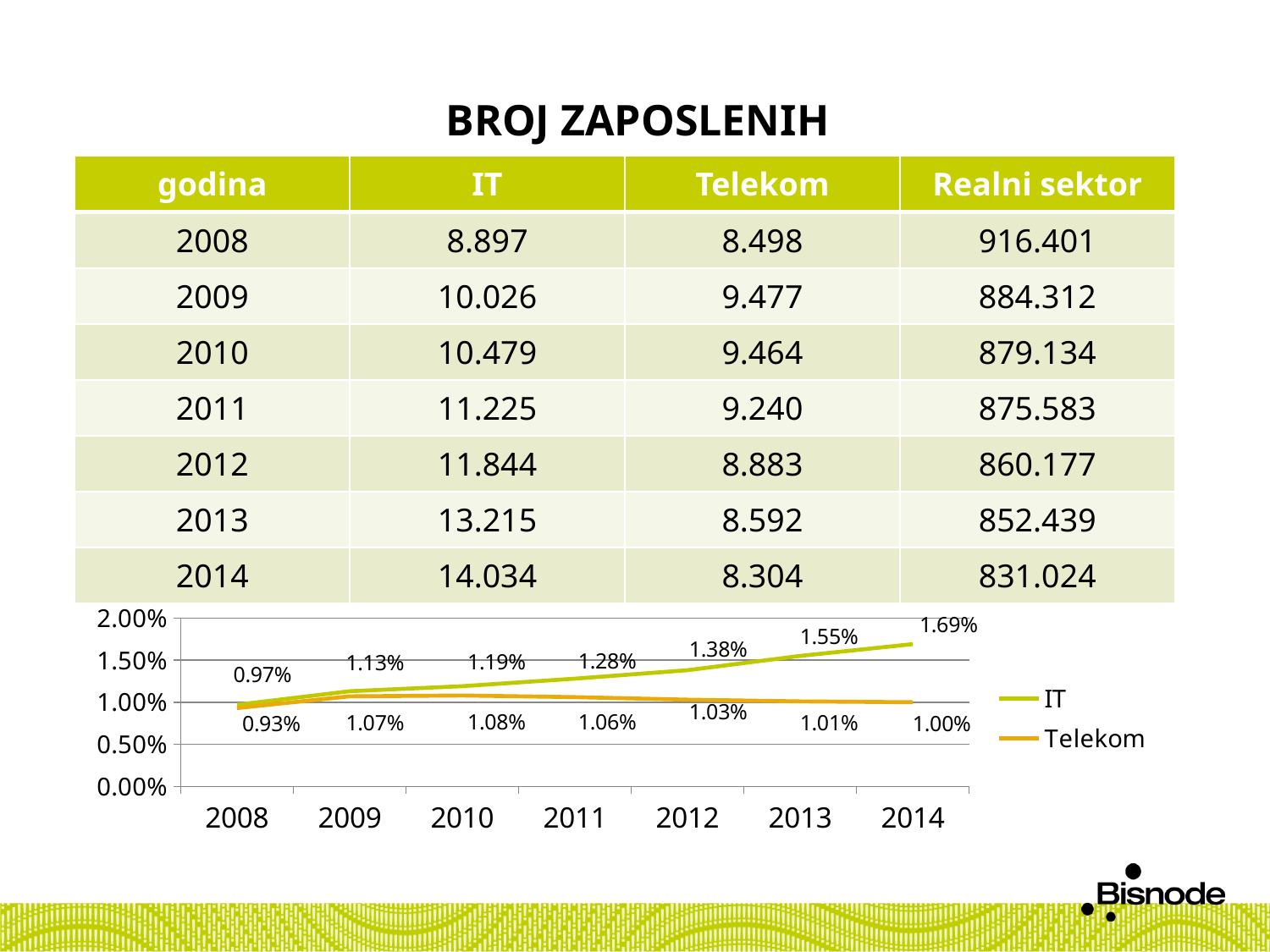
What kind of chart is shown at the bottom of the slide? line chart How many series does the chart legend list? 2 In which year does the Telekom series have its lowest value on the line chart? 2008 What is the value for Telekom in 2008 on the line chart? 0.93% In which year does the IT series reach its highest value on the line chart? 2014 What is the value for IT in 2014 on the line chart? 1.69% What is the difference between the IT and Telekom values in 2014 on the line chart? 0.69% How many years are plotted along the x axis of the line chart? 7 What is the value for Telekom in 2012 on the line chart? 1.03% What is the value for IT in 2011 on the line chart? 1.28% Which series has the larger value in 2013 on the line chart, IT or Telekom? IT Does the IT series rise or fall from 2008 to 2014 on the line chart? rise